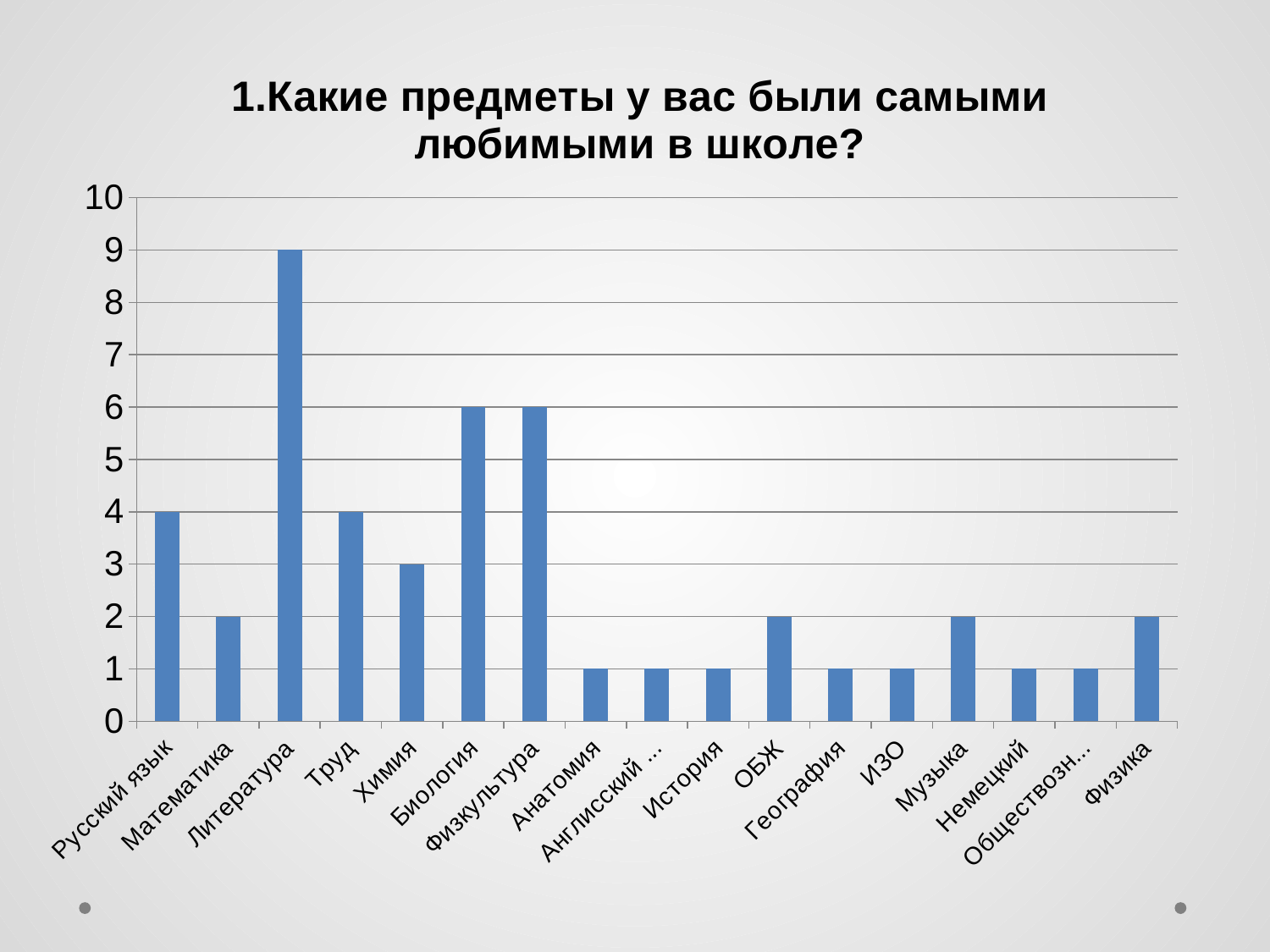
Is the value for Литература greater or less than 8? greater How many subjects (categories) are shown on the x axis? 17 Which subject has the highest bar? Литература What kind of chart is shown on the slide? bar chart What is the value for Химия? 3 What is the value for Русский язык? 4 What is the title of the chart? 1.Какие предметы у вас были самыми любимыми в школе? What is the value for Литература? 9 What is the value for Биология? 6 What is the difference between the values for Литература and Физкультура? 3 What is the value for ОБЖ? 2 Which is larger, the value for Русский язык or the value for Математика? Русский язык